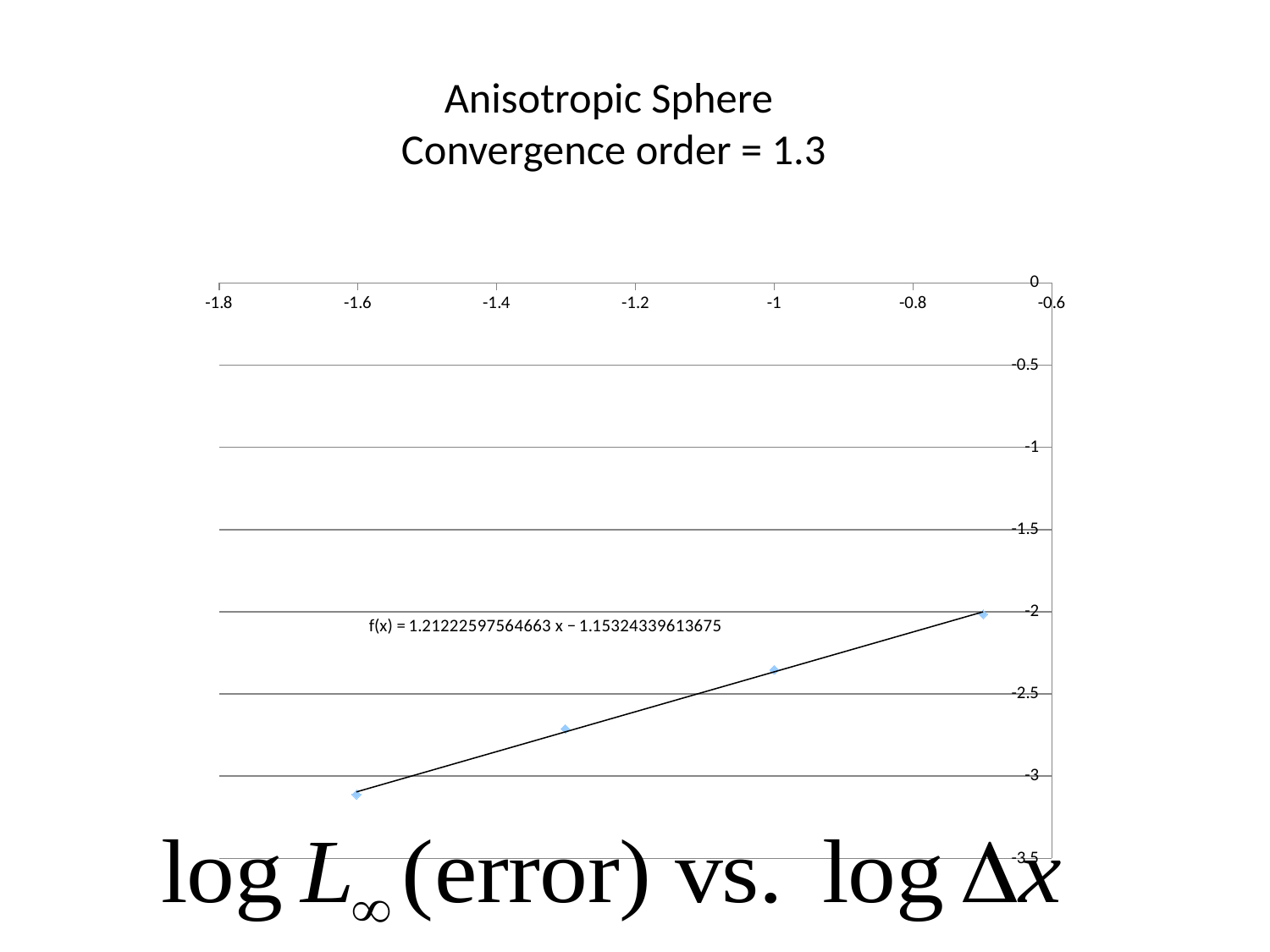
What convergence order is stated in the chart title? 1.3 Which data point has the lowest value: the one near x = -1.6 or the one near x = -0.7? the one near x = -1.6 What kind of chart is shown on the slide? scatter chart Do the plotted values rise or fall as x increases from -1.8 toward -0.6? rise How many data points are plotted on the chart? 4 Which data point has the higher value: the one near x = -1.3 or the one near x = -1? the one near x = -1 What is the slope of the fitted trendline shown in the equation on the chart? 1.21222597564663 Is the value of the leftmost data point (near x = -1.6) greater or less than -3? less Is the value of the data point near x = -1 greater or less than -2.5? greater Is the value of the data point near x = -1.3 greater or less than -2.5? less